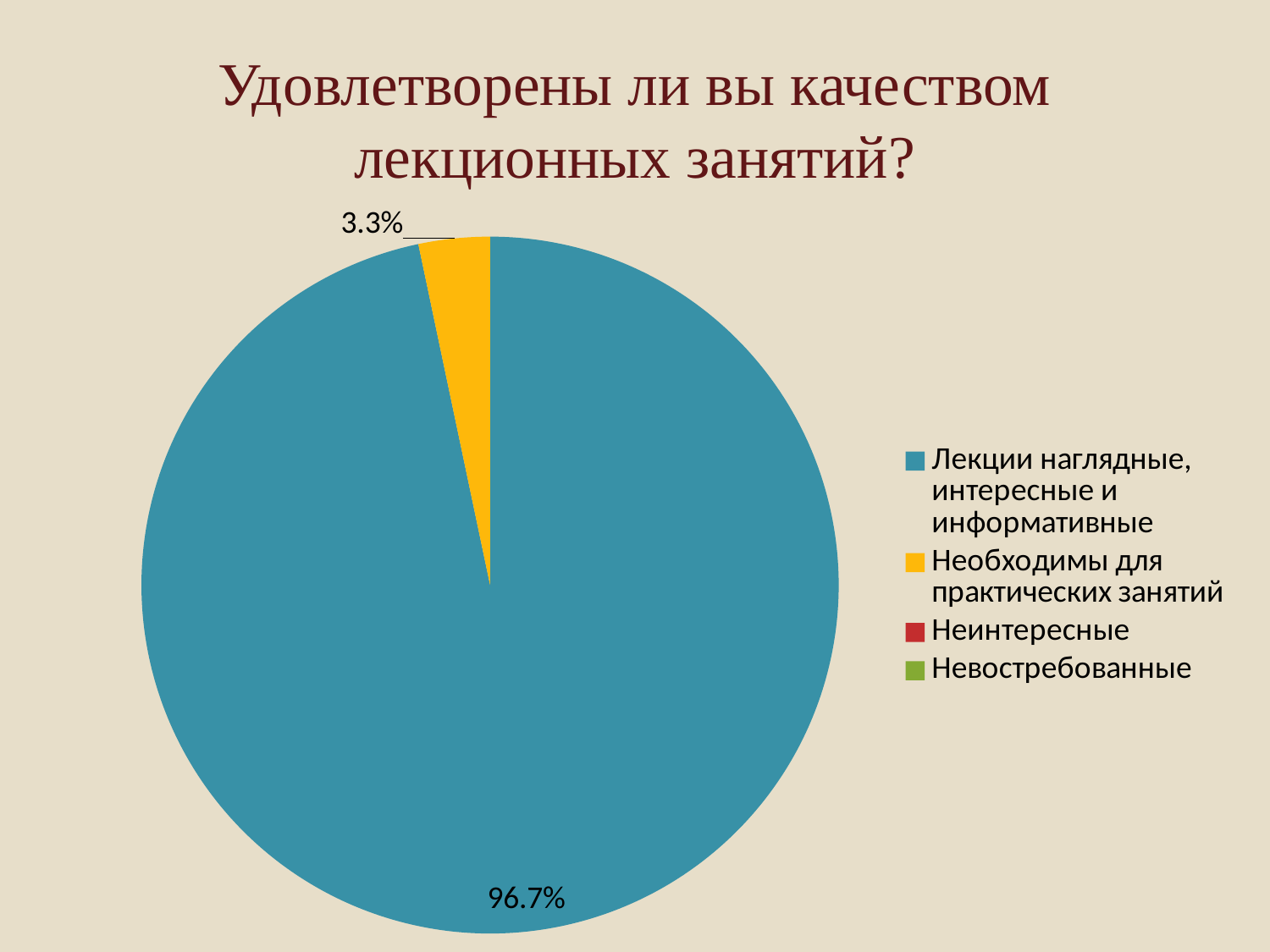
By how many percentage points does the "Лекции наглядные, интересные и информативные" share exceed the "Необходимы для практических занятий" share? 93.4 What is the title of the slide? Удовлетворены ли вы качеством лекционных занятий? What kind of chart is shown on the slide? Pie chart What percentage of respondents answered "Необходимы для практических занятий"? 3.3% Which of the two labelled slices is smaller? Необходимы для практических занятий What share of the pie does the yellow slice represent? 3.3% Which category has the largest share of the pie? Лекции наглядные, интересные и информативные What colour is the slice for "Лекции наглядные, интересные и информативные"? Blue How many entries does the legend list? 4 What percentage of respondents answered "Лекции наглядные, интересные и информативные"? 96.7% How many slices with data labels are visible in the pie? 2 Which is larger: the share for "Необходимы для практических занятий" or the share for "Лекции наглядные, интересные и информативные"? Лекции наглядные, интересные и информативные